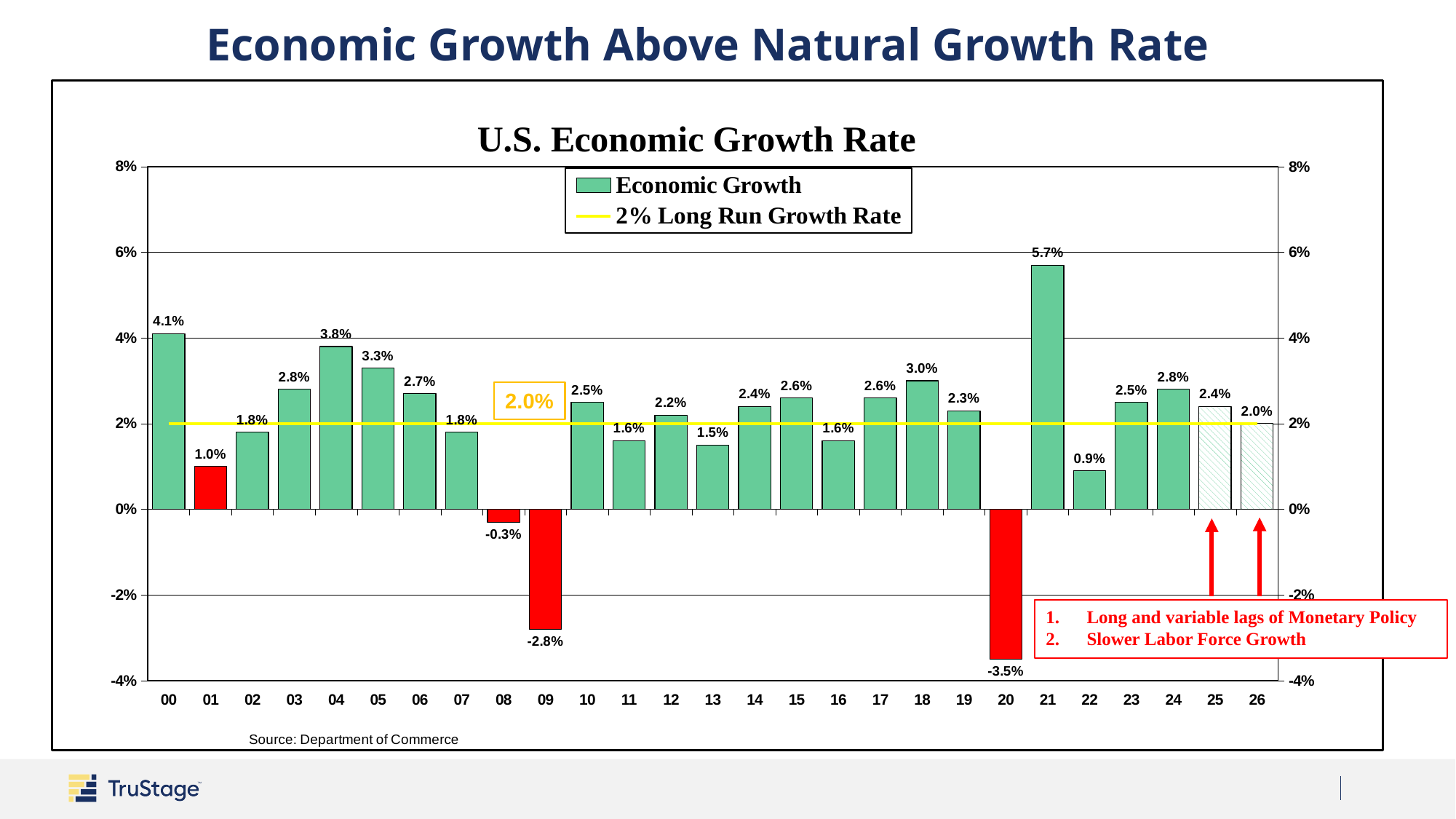
What is the economic growth rate shown for 2026? 2.0% Which year has the highest economic growth rate? 21 Which year has the lowest economic growth rate? 20 What is the title of the chart? U.S. Economic Growth Rate What is the economic growth rate shown for 2009? -2.8% Which year has a higher economic growth rate, 2004 or 2005? 04 How many series does the legend list? 2 What is the difference between the economic growth rate in 2021 and in 2022? 4.8% What is the economic growth rate shown for 2021? 5.7% What value does the yellow horizontal line represent? 2% Long Run Growth Rate What kind of chart is this? Combination bar and line chart How many years are shown on the x axis? 27